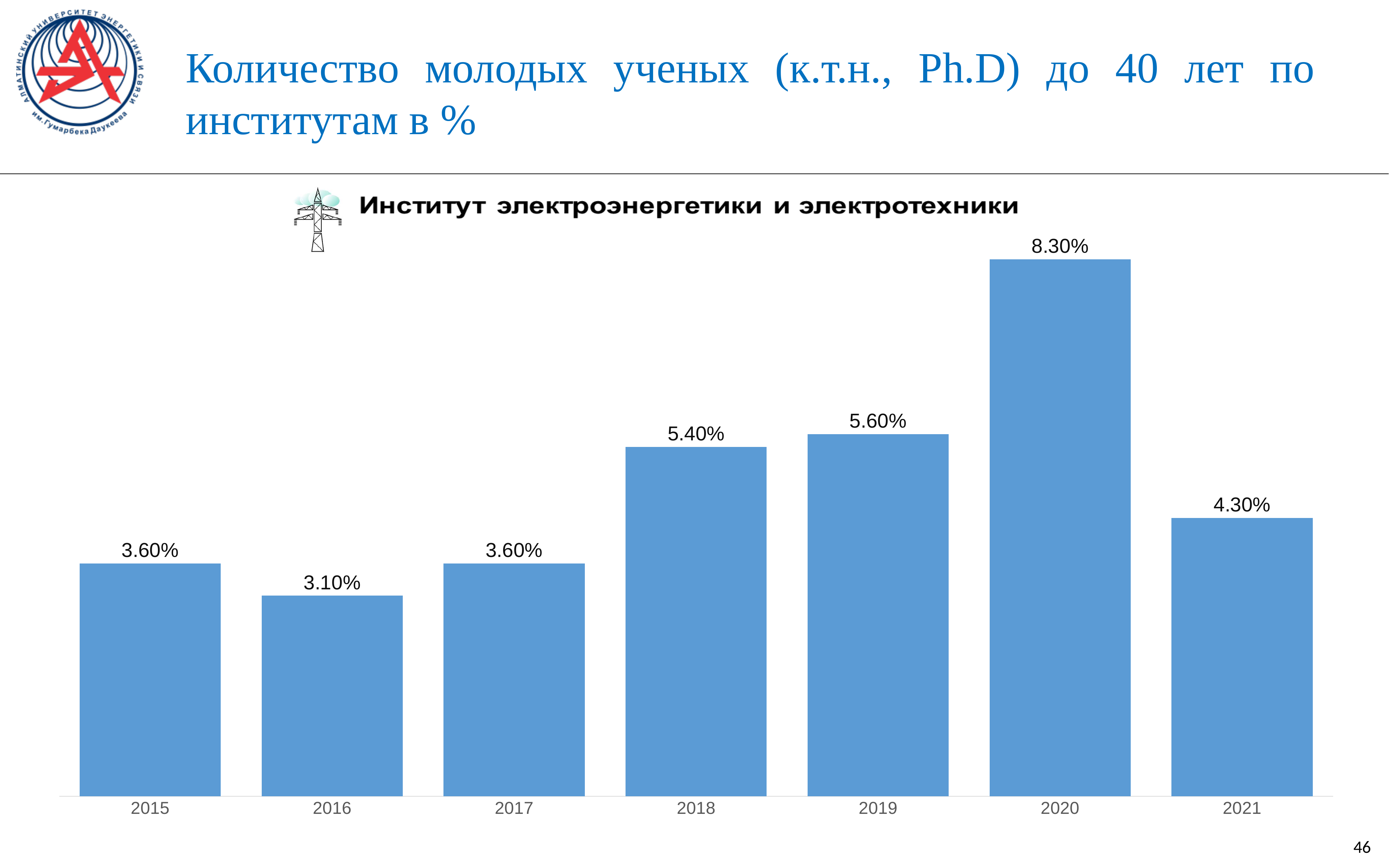
Which year has the highest value? 2020 What is the value for 2021? 4.30% What is the value for 2018? 5.40% Which is larger, the value for 2017 or the value for 2021? 2021 What is the difference between the values for 2019 and 2018? 0.20% What is the value for 2020? 8.30% What is the difference between the values for 2020 and 2021? 4.00% Which institute is named above the chart? Институт электроэнергетики и электротехники What kind of chart is this? bar chart How many years are shown on the x axis? 7 Which year has the lowest value? 2016 What is the value for 2016? 3.10%